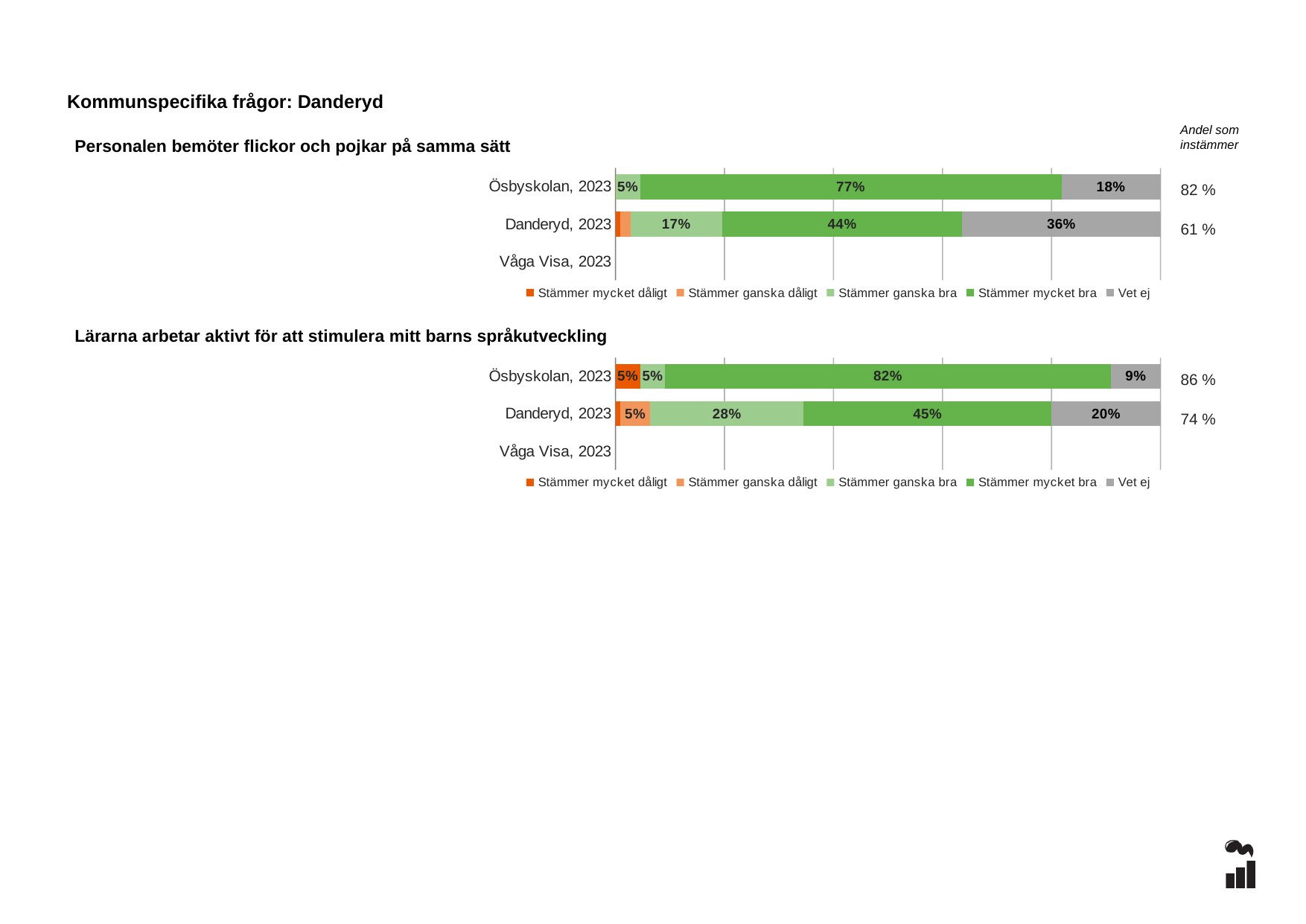
In the chart 'Lärarna arbetar aktivt för att stimulera mitt barns språkutveckling', which segment is the largest in the Ösbyskolan, 2023 bar? Stämmer mycket bra In the chart 'Personalen bemöter flickor och pojkar på samma sätt', what is the 'Vet ej' value for Danderyd, 2023? 36% In the chart 'Lärarna arbetar aktivt för att stimulera mitt barns språkutveckling', what is the difference between the 'Stämmer mycket bra' values for Ösbyskolan, 2023 and Danderyd, 2023? 37% In the chart 'Personalen bemöter flickor och pojkar på samma sätt', what is the 'Stämmer mycket bra' value for Ösbyskolan, 2023? 77% How many series does the legend list in the chart 'Personalen bemöter flickor och pojkar på samma sätt'? 5 In the chart 'Personalen bemöter flickor och pojkar på samma sätt', which has the larger 'Vet ej' value, Ösbyskolan, 2023 or Danderyd, 2023? Danderyd, 2023 In the chart 'Personalen bemöter flickor och pojkar på samma sätt', what is the 'Andel som instämmer' figure shown for Danderyd, 2023? 61 % In the chart 'Lärarna arbetar aktivt för att stimulera mitt barns språkutveckling', what is the 'Vet ej' value for Ösbyskolan, 2023? 9% How many category rows are shown on the y axis of the chart 'Lärarna arbetar aktivt för att stimulera mitt barns språkutveckling'? 3 In the chart 'Lärarna arbetar aktivt för att stimulera mitt barns språkutveckling', what is the 'Andel som instämmer' figure shown for Ösbyskolan, 2023? 86 % What kind of chart is 'Personalen bemöter flickor och pojkar på samma sätt'? Stacked bar chart In the chart 'Lärarna arbetar aktivt för att stimulera mitt barns språkutveckling', what is the 'Stämmer ganska bra' value for Danderyd, 2023? 28%